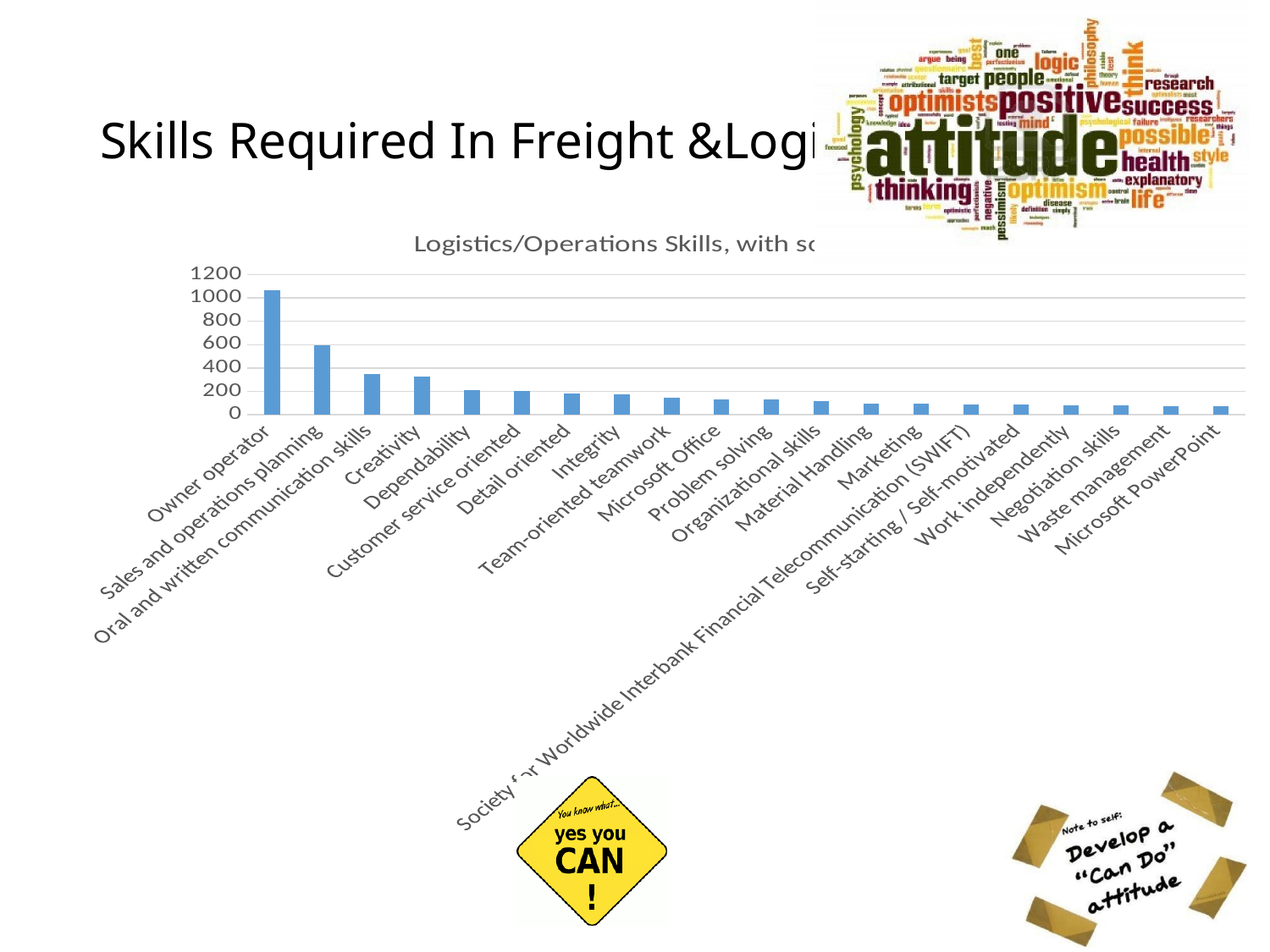
Do the values rise or fall moving from left to right along the x axis? fall Is the value for Creativity greater or less than 200? greater How many skill categories are plotted in the chart? 20 Is the value for Microsoft PowerPoint greater or less than 200? less Is the value for Sales and operations planning greater or less than 400? greater Which has a larger value, Creativity or Detail oriented? Creativity Which has a larger value, Owner operator or Sales and operations planning? Owner operator Which skill has the highest value in the chart? Owner operator What kind of chart is shown on the slide? bar chart